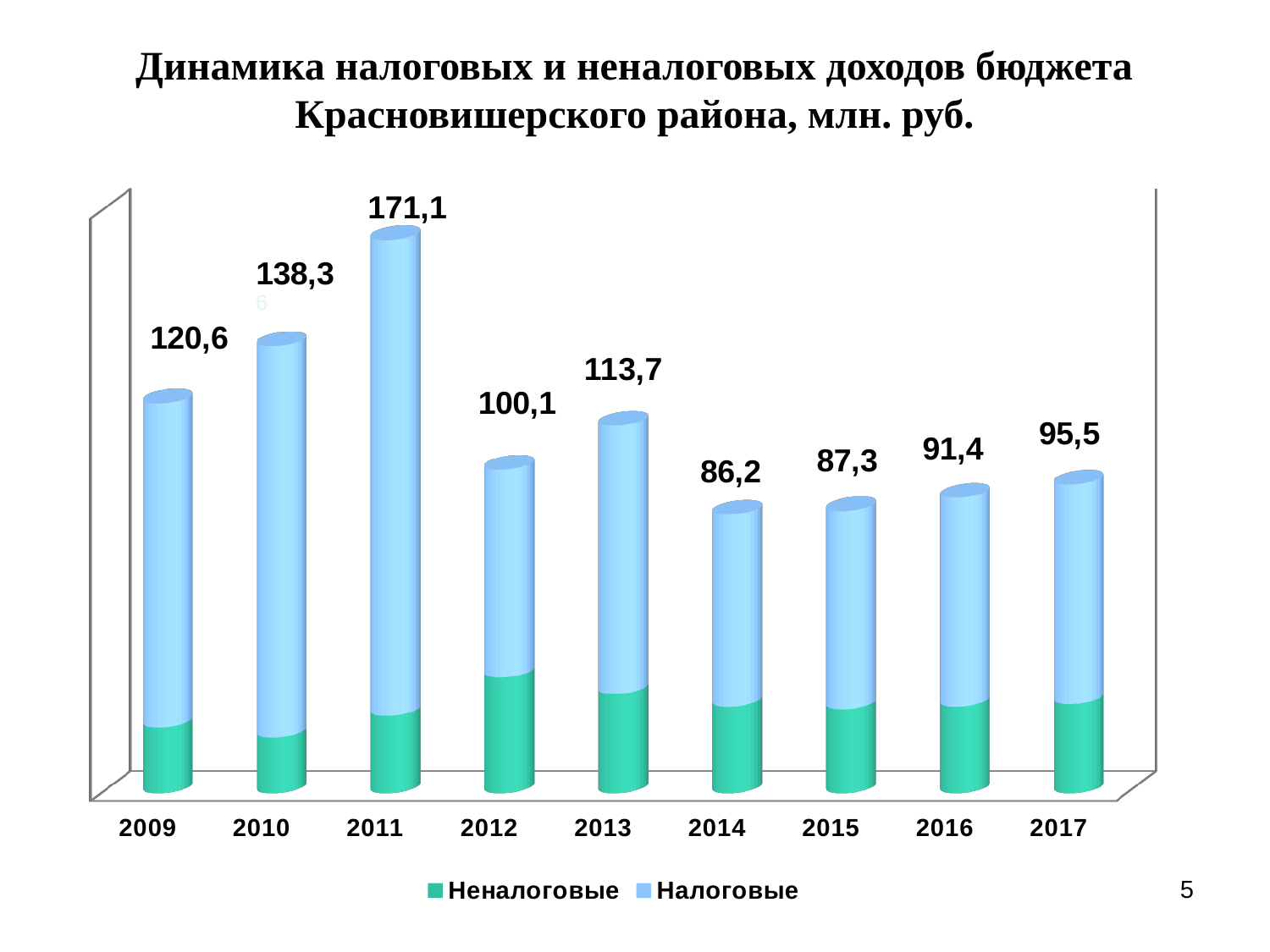
Which year has a larger total, 2013 or 2016? 2013 What kind of chart is shown on the slide? Stacked bar chart Which year has the highest total revenue? 2011 What is the difference between the totals for 2011 and 2012? 71,0 How many series does the legend list? 2 Do the total values rise or fall from 2014 to 2017? Rise What is the difference between the totals for 2010 and 2009? 17,7 What is the total value labelled above the bar for 2014? 86,2 How many years are shown on the x axis? 9 Which year has the lowest total revenue? 2014 What is the total budget revenue shown for 2011? 171,1 What is the total value shown for 2017? 95,5